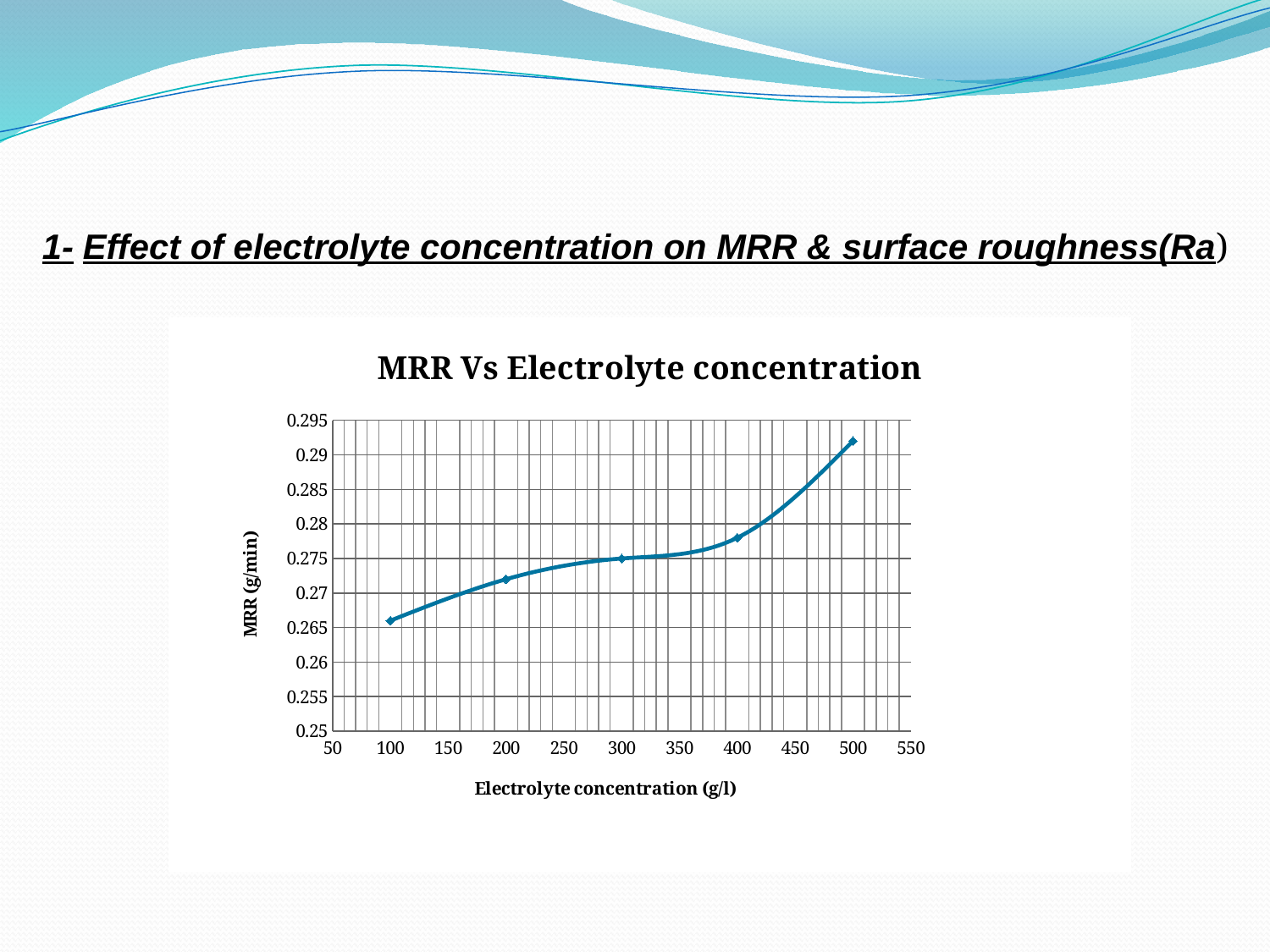
What kind of chart is shown on the slide? line chart At which electrolyte concentration is the MRR highest? 500 At which electrolyte concentration is the MRR lowest? 100 How many data points are plotted on the chart? 5 Is the MRR at an electrolyte concentration of 100 g/l greater or less than 0.27? less Does the MRR rise or fall as electrolyte concentration increases? rise Is the MRR at an electrolyte concentration of 400 g/l greater or less than 0.275? greater Is the MRR at an electrolyte concentration of 500 g/l greater or less than 0.29? greater Which has the larger MRR: an electrolyte concentration of 200 g/l or 500 g/l? 500 g/l What is the title of the chart? MRR Vs Electrolyte concentration What is the label of the y axis? MRR (g/min)